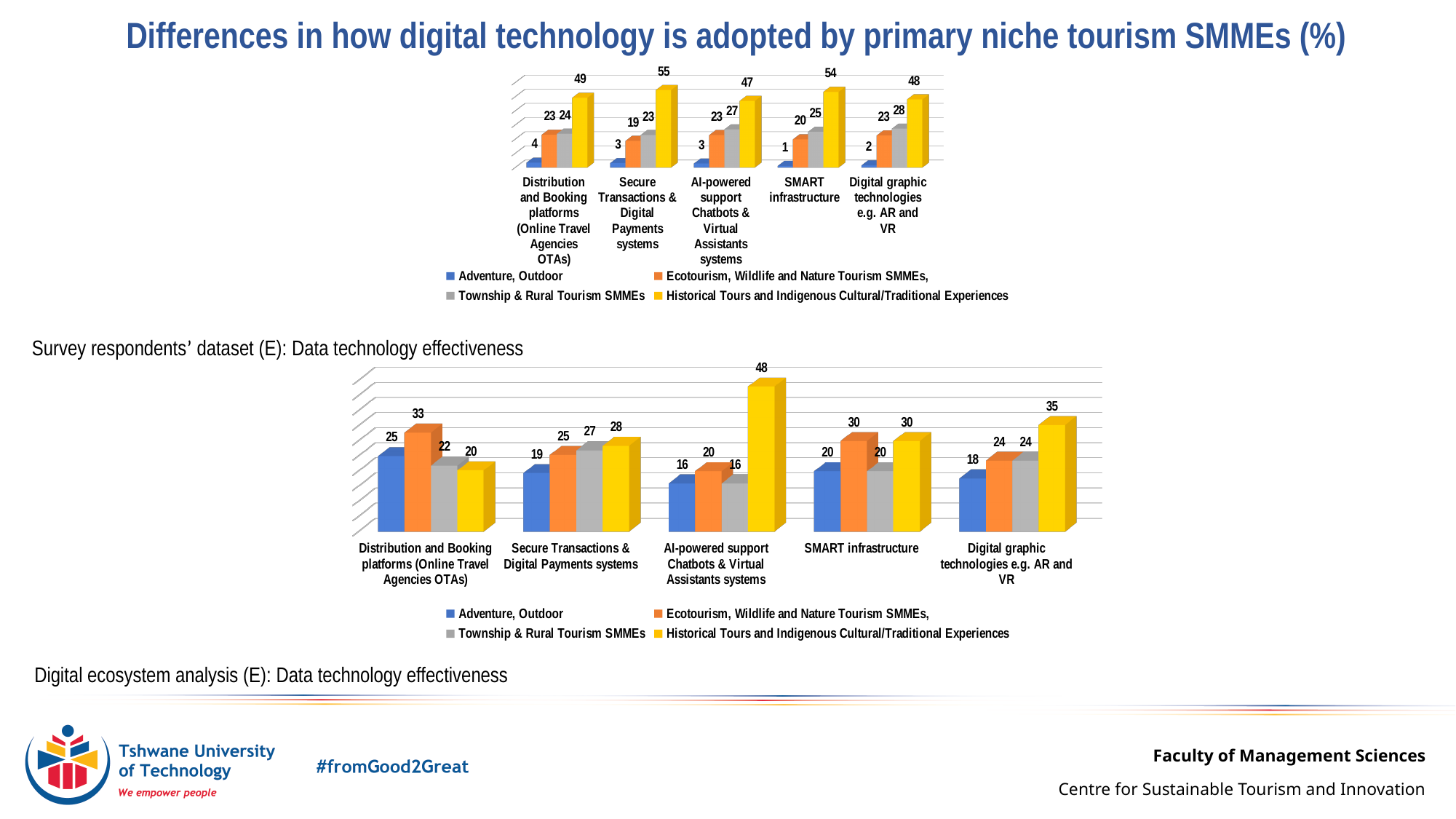
In the bottom chart (Digital ecosystem analysis), which category has the highest value for Historical Tours and Indigenous Cultural/Traditional Experiences? AI-powered support Chatbots & Virtual Assistants systems How many series does the legend of the top chart (Survey respondents' dataset) list? 4 How many categories are shown on the x axis of the bottom chart (Digital ecosystem analysis)? 5 In the top chart (Survey respondents' dataset), what is the value for Adventure, Outdoor for SMART infrastructure? 1 In the bottom chart (Digital ecosystem analysis), what is the difference between the Historical Tours value and the Adventure, Outdoor value for AI-powered support Chatbots & Virtual Assistants systems? 32 In the top chart (Survey respondents' dataset), what is the difference between the Historical Tours value and the Township & Rural Tourism SMMEs value for SMART infrastructure? 29 What kind of chart is the bottom chart (Digital ecosystem analysis)? Bar chart In the top chart (Survey respondents' dataset), which category has the highest value for Historical Tours and Indigenous Cultural/Traditional Experiences? Secure Transactions & Digital Payments systems In the top chart (Survey respondents' dataset), what is the value for Historical Tours and Indigenous Cultural/Traditional Experiences for Secure Transactions & Digital Payments systems? 55 In the bottom chart (Digital ecosystem analysis), which category has the lowest value for Adventure, Outdoor? AI-powered support Chatbots & Virtual Assistants systems In the bottom chart (Digital ecosystem analysis), what is the value for Ecotourism, Wildlife and Nature Tourism SMMEs for Distribution and Booking platforms (Online Travel Agencies OTAs)? 33 In the bottom chart (Digital ecosystem analysis), which is larger for Digital graphic technologies e.g. AR and VR: the Adventure, Outdoor value or the Historical Tours value? Historical Tours